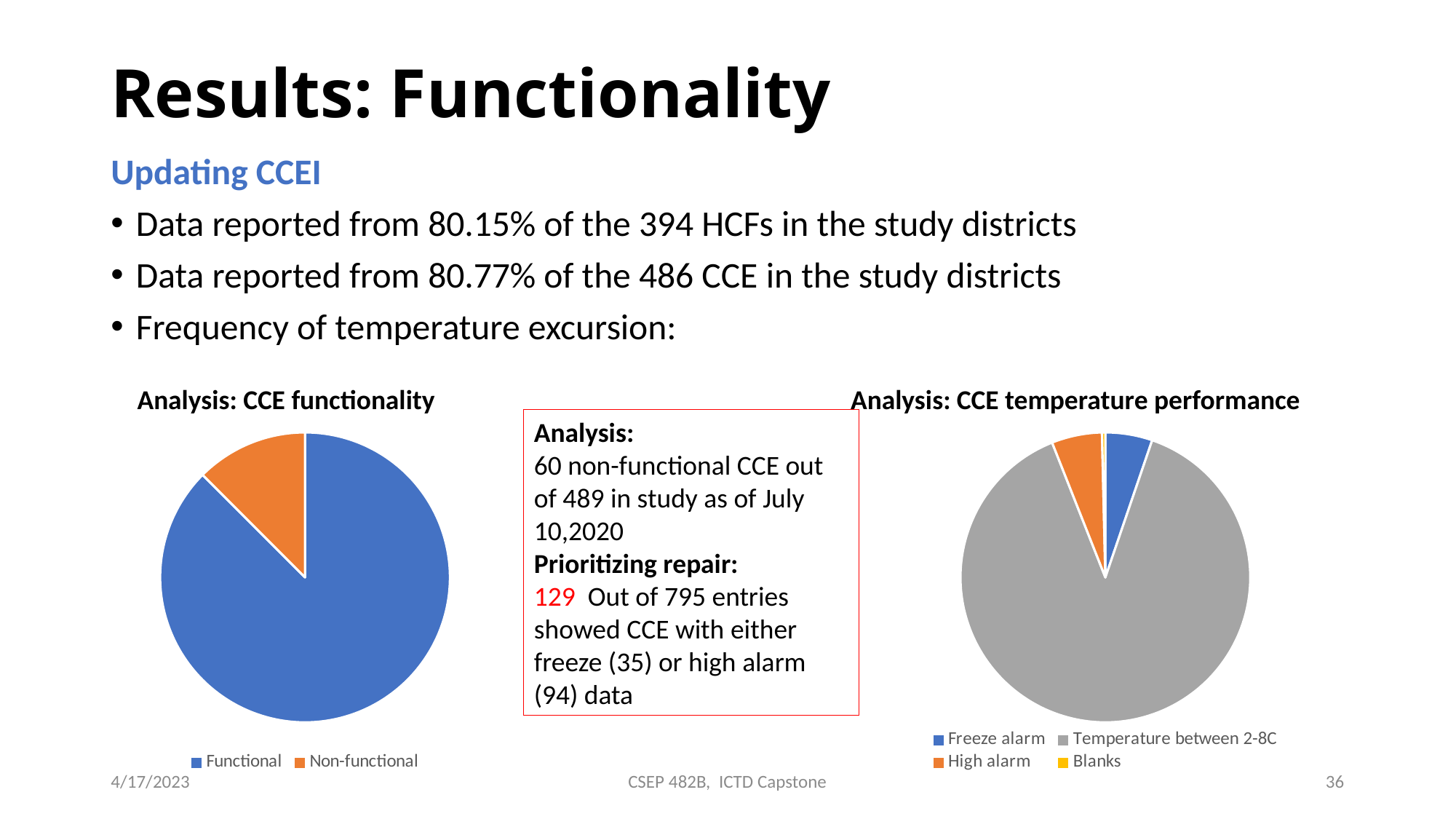
In the "Analysis: CCE functionality" chart, what colour is the Non-functional slice? Orange In the "Analysis: CCE temperature performance" chart, which category has the largest slice? Temperature between 2-8C In the "Analysis: CCE functionality" chart, which category has the largest slice? Functional In the "Analysis: CCE functionality" chart, which slice is larger: Functional or Non-functional? Functional In the "Analysis: CCE temperature performance" chart, what colour is the Temperature between 2-8C slice? Grey In the "Analysis: CCE functionality" chart, which category has the smallest slice? Non-functional What kind of chart is "Analysis: CCE functionality"? Pie chart In the "Analysis: CCE temperature performance" chart, which slice is larger: Freeze alarm or High alarm? High alarm In the "Analysis: CCE functionality" chart, how many categories does the legend list? 2 In the "Analysis: CCE temperature performance" chart, which category has the smallest slice? Blanks What kind of chart is "Analysis: CCE temperature performance"? Pie chart In the "Analysis: CCE temperature performance" chart, how many categories does the legend list? 4